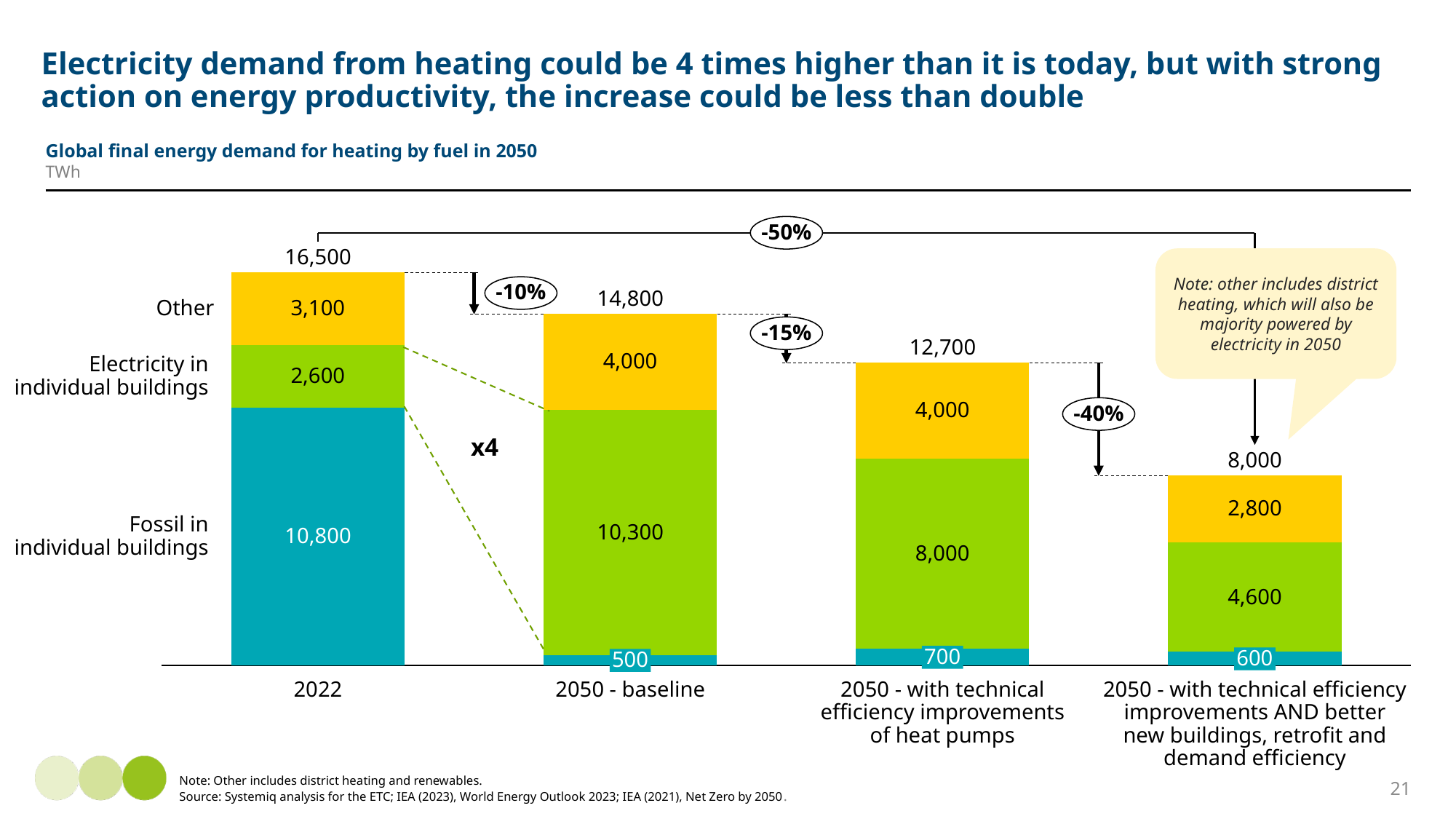
How many scenarios (bars) are shown in the chart? 4 What is the difference between the total for 2022 and the total for 2050 - baseline? 1,700 What type of chart is shown on the slide? Stacked bar chart What unit is the chart measured in? TWh What is the value for Electricity in individual buildings in the 2050 - baseline scenario? 10,300 How many fuel categories are stacked in each bar? 3 What is the total of the 2050 - with technical efficiency improvements of heat pumps bar? 12,700 Which scenario has the highest total final energy demand for heating? 2022 What is the value for Other in the 2050 scenario with technical efficiency improvements AND better new buildings, retrofit and demand efficiency? 2,800 Which scenario has the lowest total final energy demand for heating? 2050 - with technical efficiency improvements AND better new buildings, retrofit and demand efficiency Which is larger: Electricity in individual buildings in 2050 - baseline or in 2050 - with technical efficiency improvements of heat pumps? 2050 - baseline What is the value for Fossil in individual buildings in 2022? 10,800